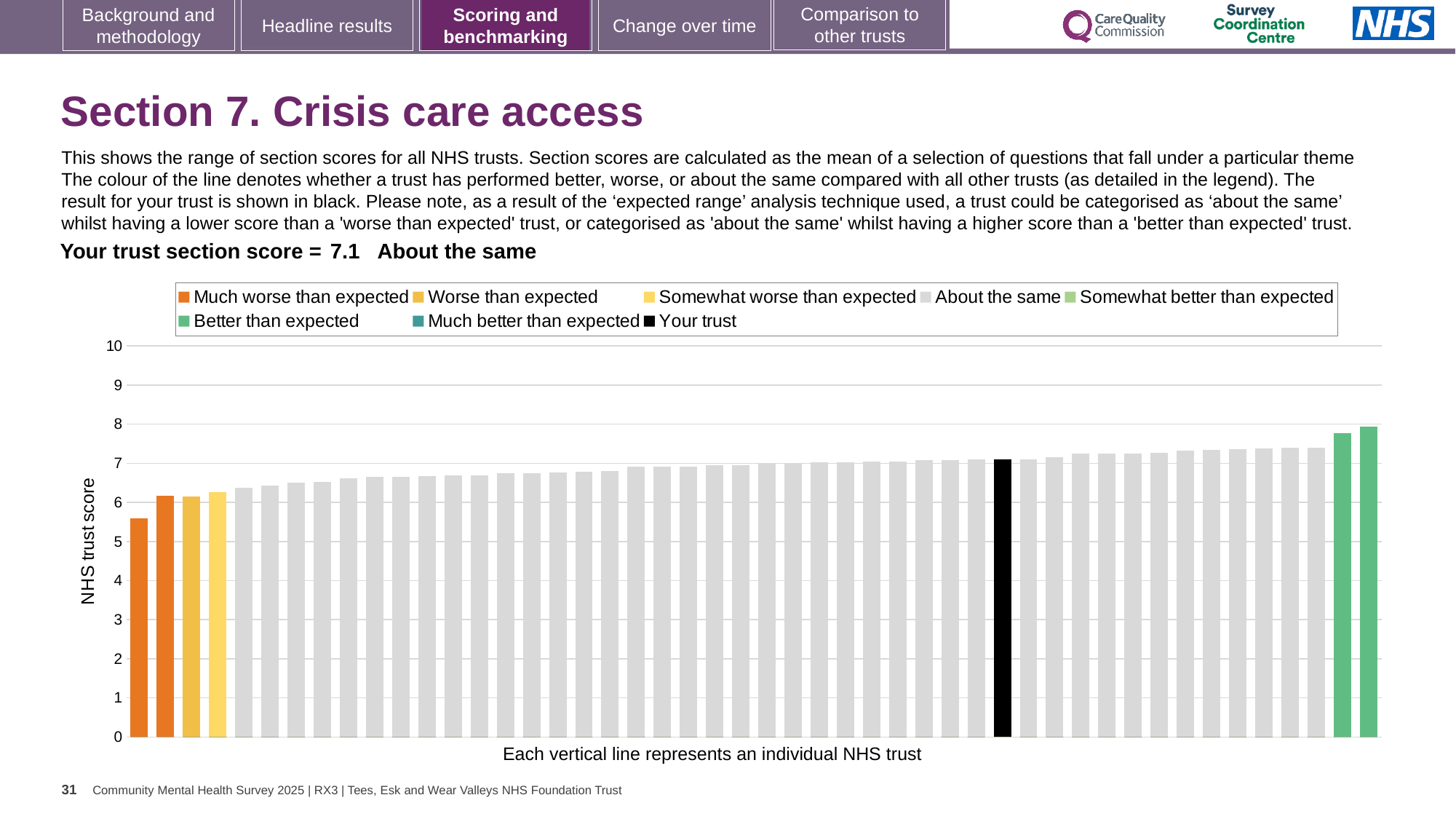
What is the section score for your trust? 7.1 Which legend category is your trust placed in? About the same Is the value of the tallest bar (the rightmost green bar) greater or less than 7? greater What is the label on the vertical axis of the chart? NHS trust score Is the value of the lowest bar (the leftmost orange bar) greater or less than 6? less Which is larger: the black 'Your trust' bar or the leftmost orange bar? the black 'Your trust' bar Do the bar values rise or fall from left to right along the x axis? rise What kind of chart is shown on the slide? bar chart Which legend category does the tallest bar belong to? Better than expected How many bars are coloured as 'Much worse than expected' (orange)? 2 How many bars are coloured as 'Better than expected' (green)? 2 How many entries does the chart legend list? 8